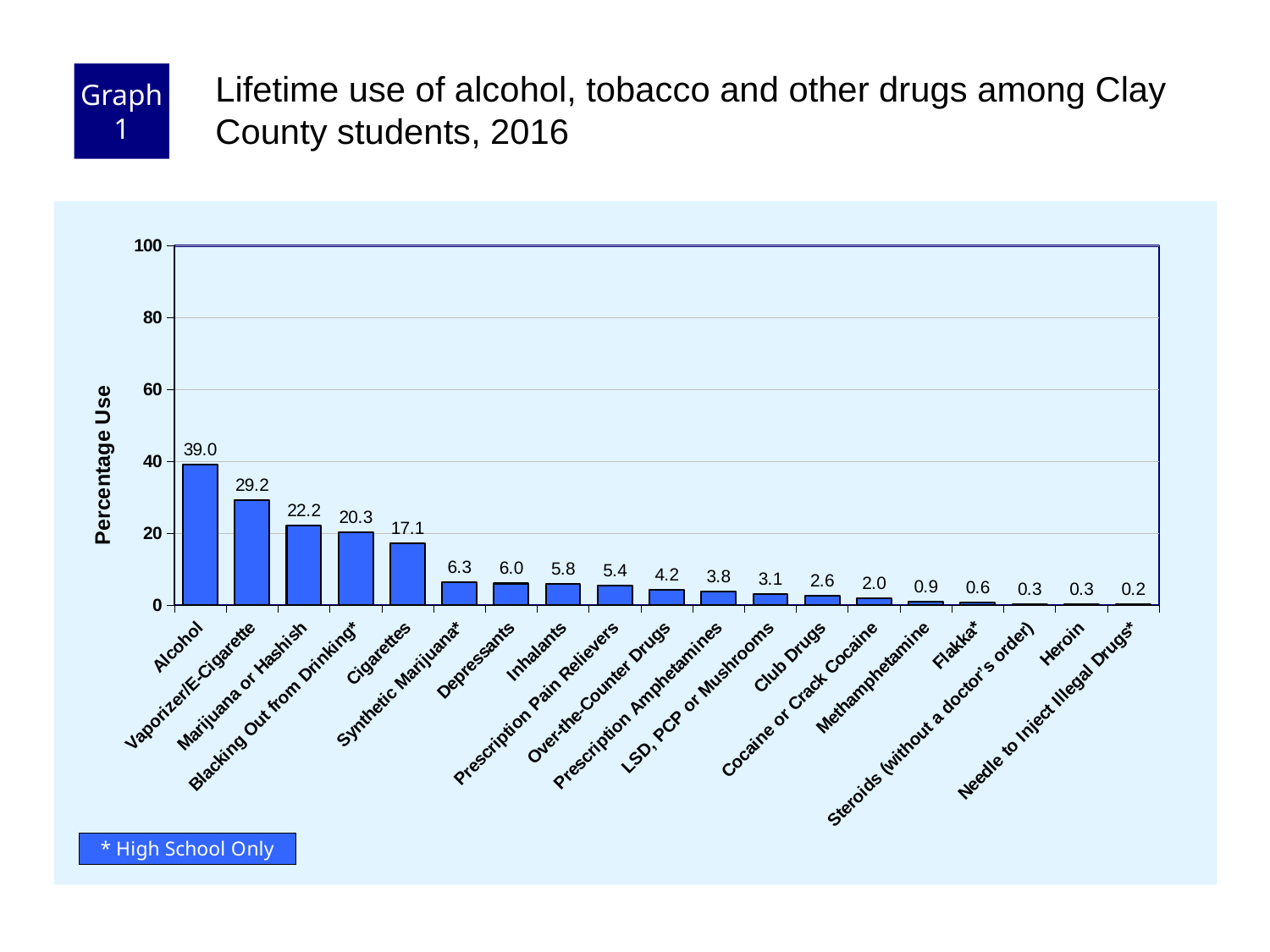
Is the value for Cigarettes greater or less than 20? less How many categories are shown on the chart? 19 What is the percentage use for Alcohol? 39.0 Which category has the highest percentage use? Alcohol Which has a higher percentage use, Marijuana or Hashish or Blacking Out from Drinking*? Marijuana or Hashish What kind of chart is shown on the slide? Bar chart What is the percentage use for Vaporizer/E-Cigarette? 29.2 What is the label of the y axis? Percentage Use What is the difference in percentage use between Alcohol and Vaporizer/E-Cigarette? 9.8 What is the percentage use for Cigarettes? 17.1 What is the percentage use for Methamphetamine? 0.9 Which category has the lowest percentage use? Needle to Inject Illegal Drugs*